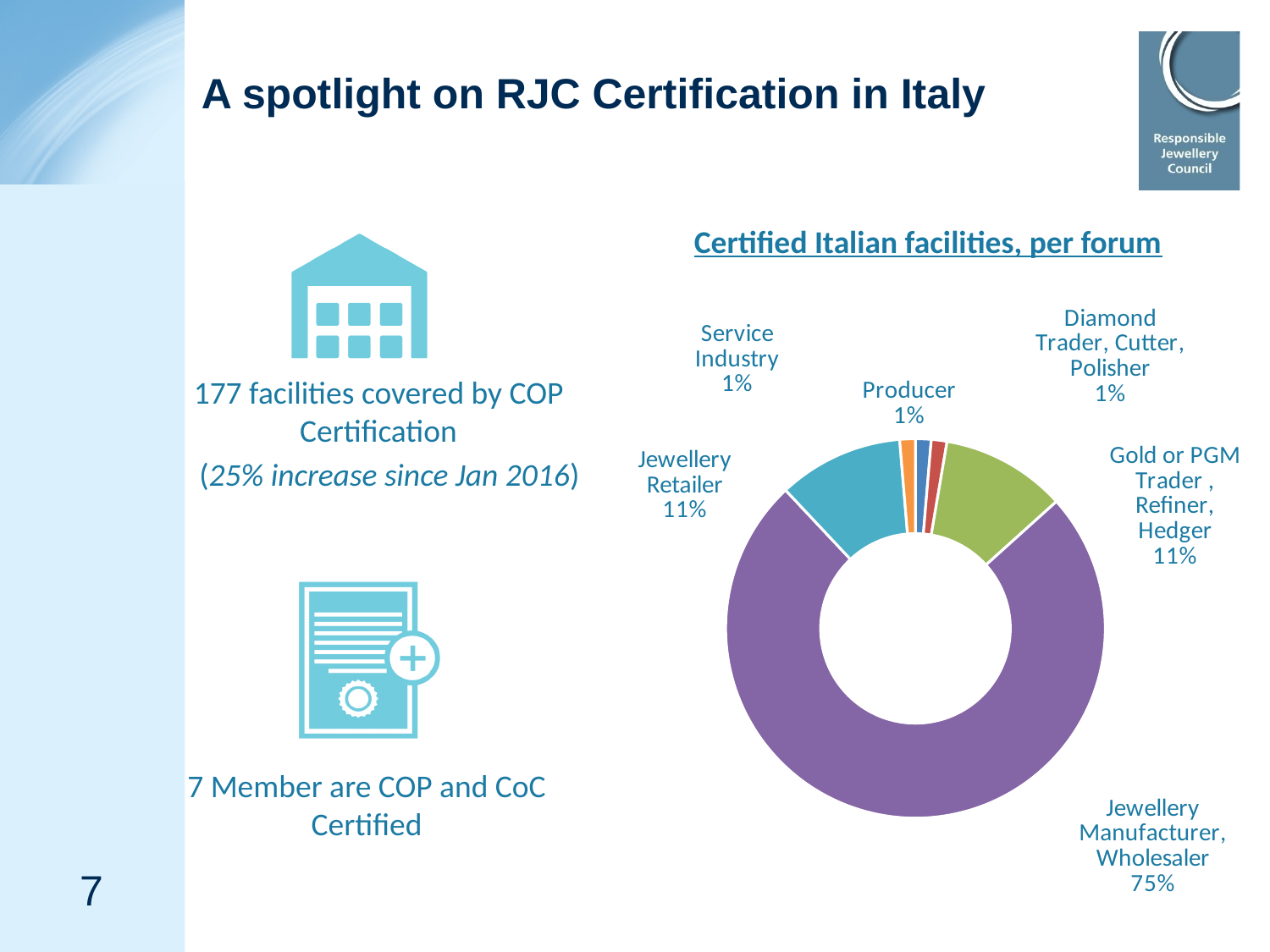
What percentage is shown for Service Industry? 1% What percentage is shown for Diamond Trader, Cutter, Polisher? 1% What percentage is shown for Jewellery Retailer? 11% What is the title of the chart? Certified Italian facilities, per forum What share of certified Italian facilities is Jewellery Manufacturer, Wholesaler? 75% What type of chart is shown on the slide? Doughnut chart What percentage is shown for Producer? 1% How many forum categories are shown in the chart? 6 What is the difference in percentage points between Jewellery Manufacturer, Wholesaler and Jewellery Retailer? 64 What is the smallest percentage shown on the chart? 1% What percentage is shown for Gold or PGM Trader, Refiner, Hedger? 11% Which forum has the largest share of certified Italian facilities? Jewellery Manufacturer, Wholesaler